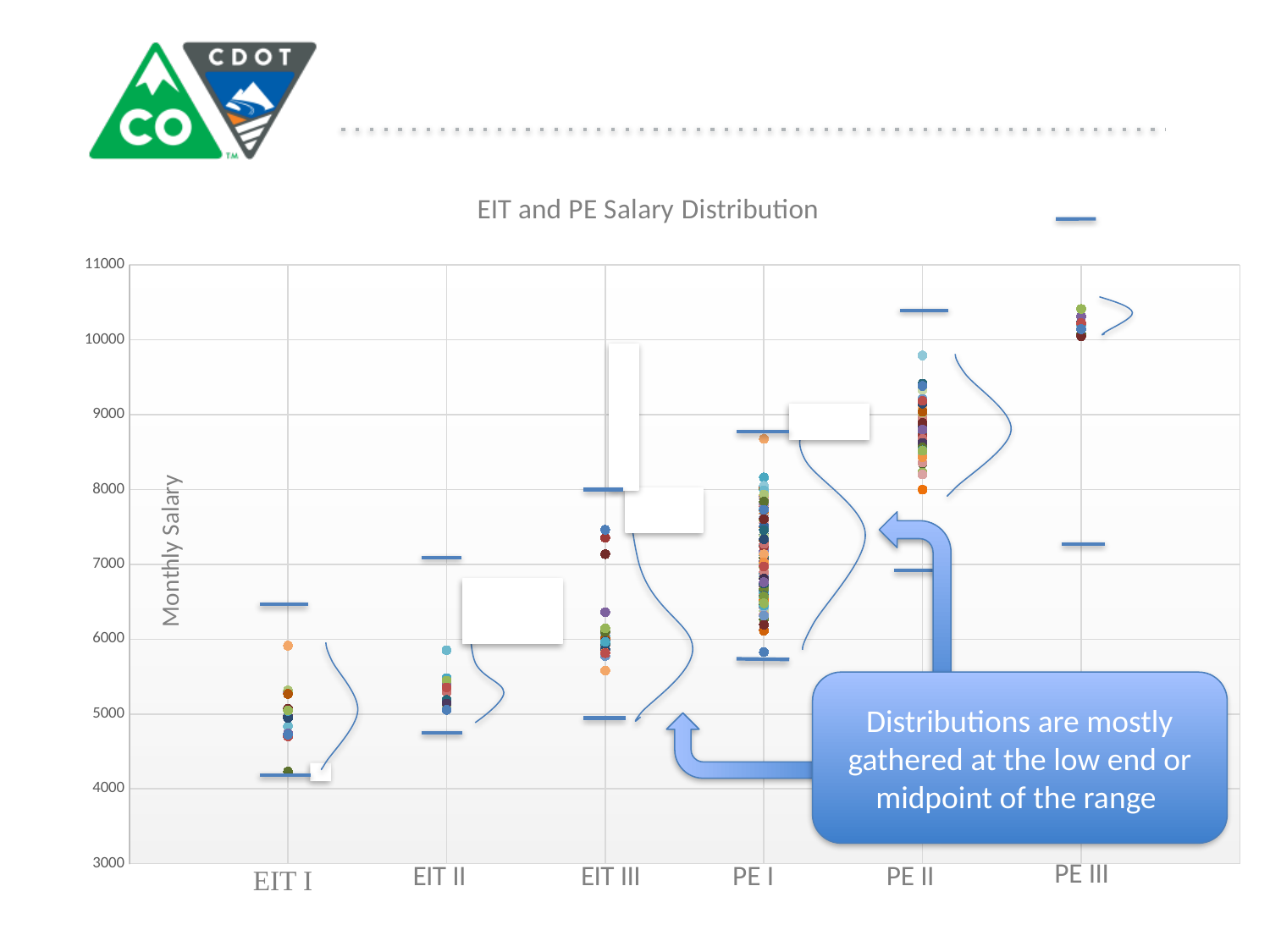
Are the salary points for EIT II greater or less than 6000? less What is the title of the chart? EIT and PE Salary Distribution Are the salary points for PE II greater or less than 7000? greater What is the label on the vertical axis of the chart? Monthly Salary Which category has the lowest salary points on the chart? EIT I Are the salary points for EIT III greater or less than 8000? less Do the salary points generally rise or fall moving from EIT I to PE III along the x axis? rise Which category has the highest salary points on the chart? PE III How many job categories are shown along the x axis? 6 What kind of chart is shown on the slide? scatter chart